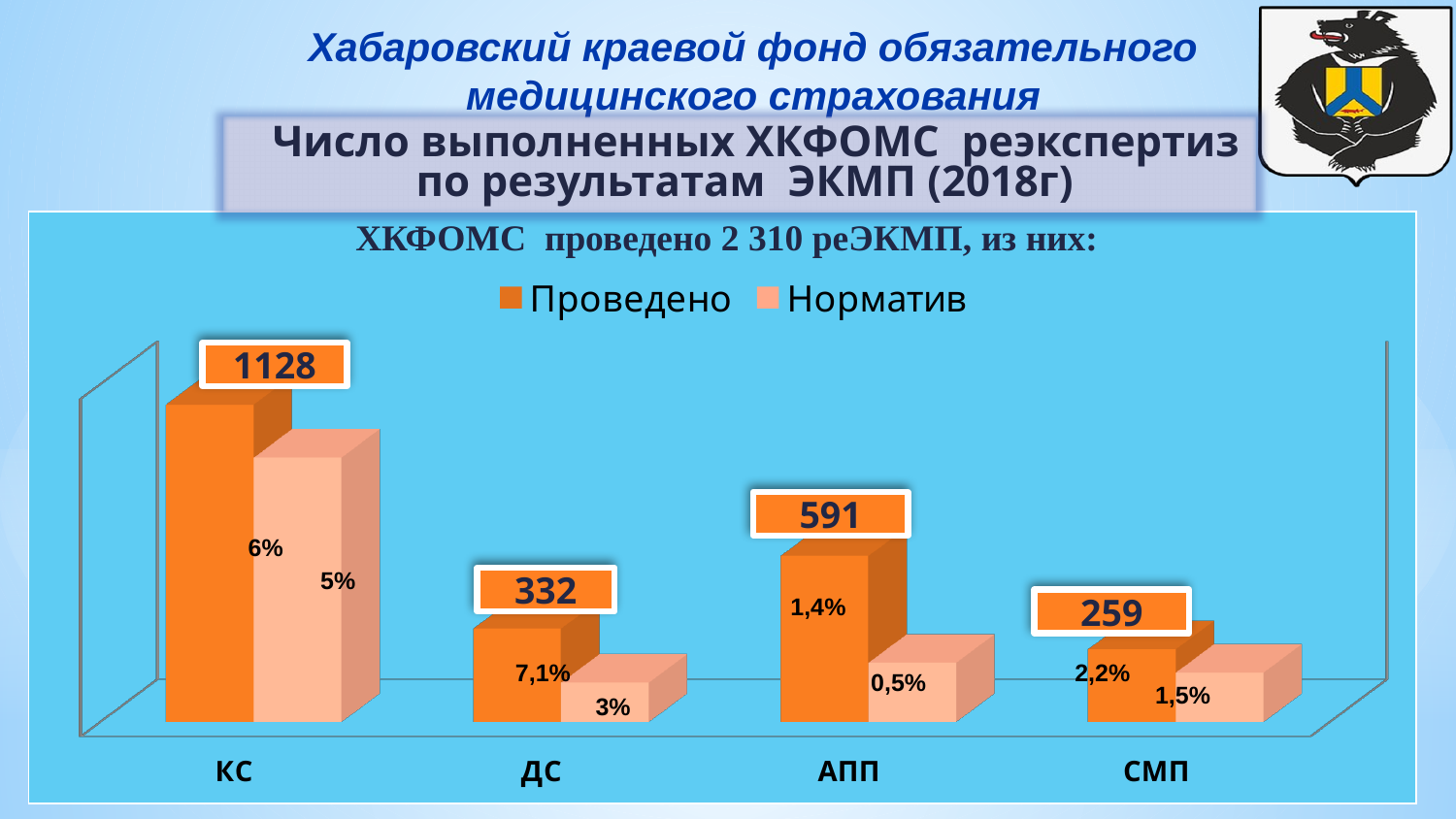
What is the Проведено value for АПП? 591 How many categories are shown on the x axis? 4 Which category has the highest Проведено value? КС How many series does the legend list? 2 Which has the larger Проведено value, ДС or АПП? АПП What is the Проведено value for ДС? 332 What is the Проведено value for СМП? 259 What is the difference between the Проведено values for КС and АПП? 537 What are the two entries in the chart legend? Проведено, Норматив What kind of chart is shown on the slide? bar chart What is the Проведено value for КС? 1128 Which category has the lowest Проведено value? СМП